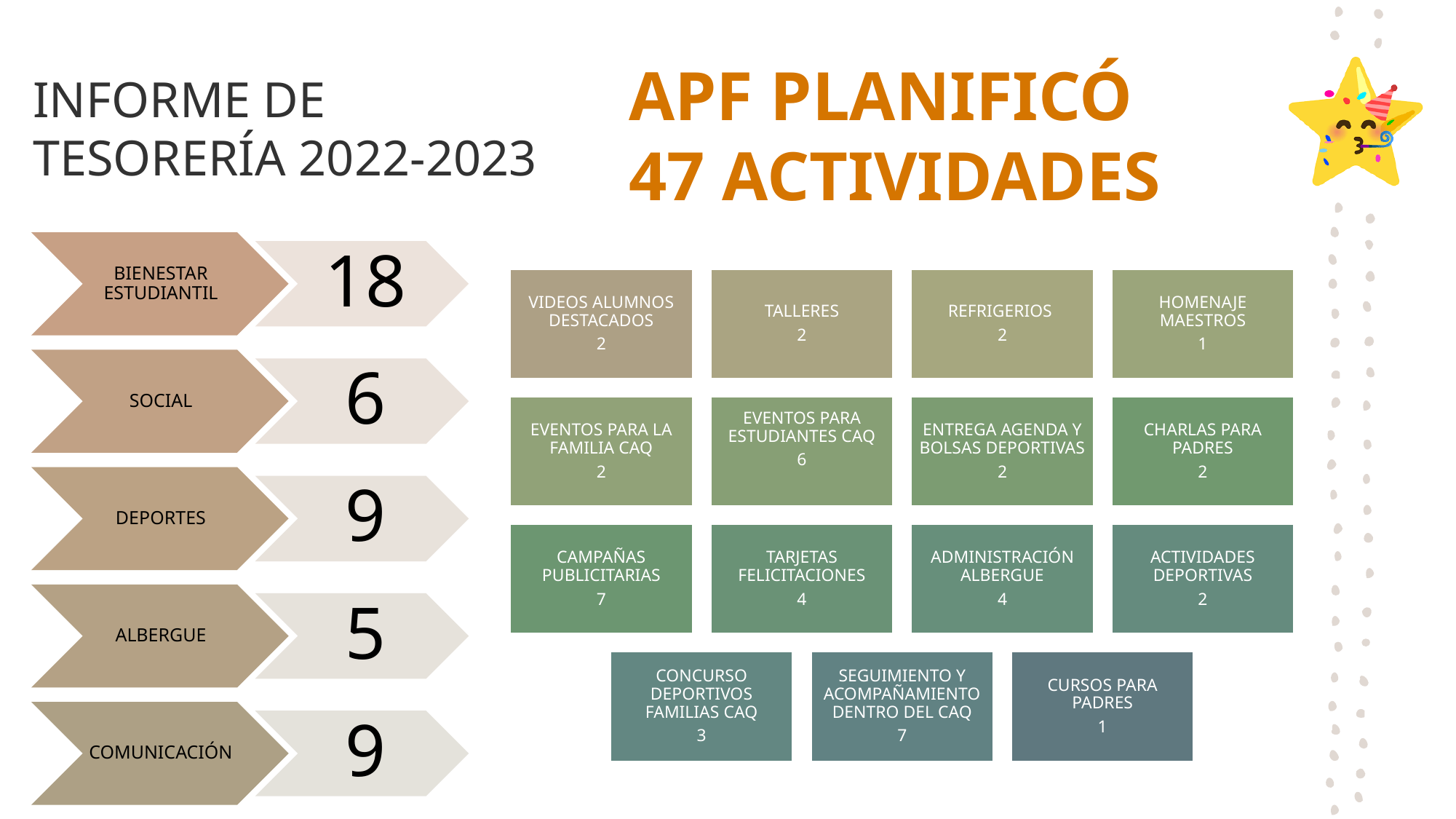
In the chevron list on the left, which category has the lowest value? ALBERGUE What is the total of the five values in the chevron list on the left? 47 In the chevron list on the left, what is the value for ALBERGUE? 5 How many boxes are in the grid on the right side of the slide? 15 What is the orange heading on the slide? APF PLANIFICÓ 47 ACTIVIDADES In the chevron list on the left, what is the value for BIENESTAR ESTUDIANTIL? 18 In the grid of boxes on the right, what is the value for EVENTOS PARA ESTUDIANTES CAQ? 6 In the chevron list on the left, which is larger, DEPORTES or SOCIAL? DEPORTES In the chevron list on the left, which category has the highest value? BIENESTAR ESTUDIANTIL In the chevron list on the left, what is the difference between BIENESTAR ESTUDIANTIL and SOCIAL? 12 How many categories are shown in the chevron list on the left? 5 In the grid of boxes on the right, what is the value for CAMPAÑAS PUBLICITARIAS? 7